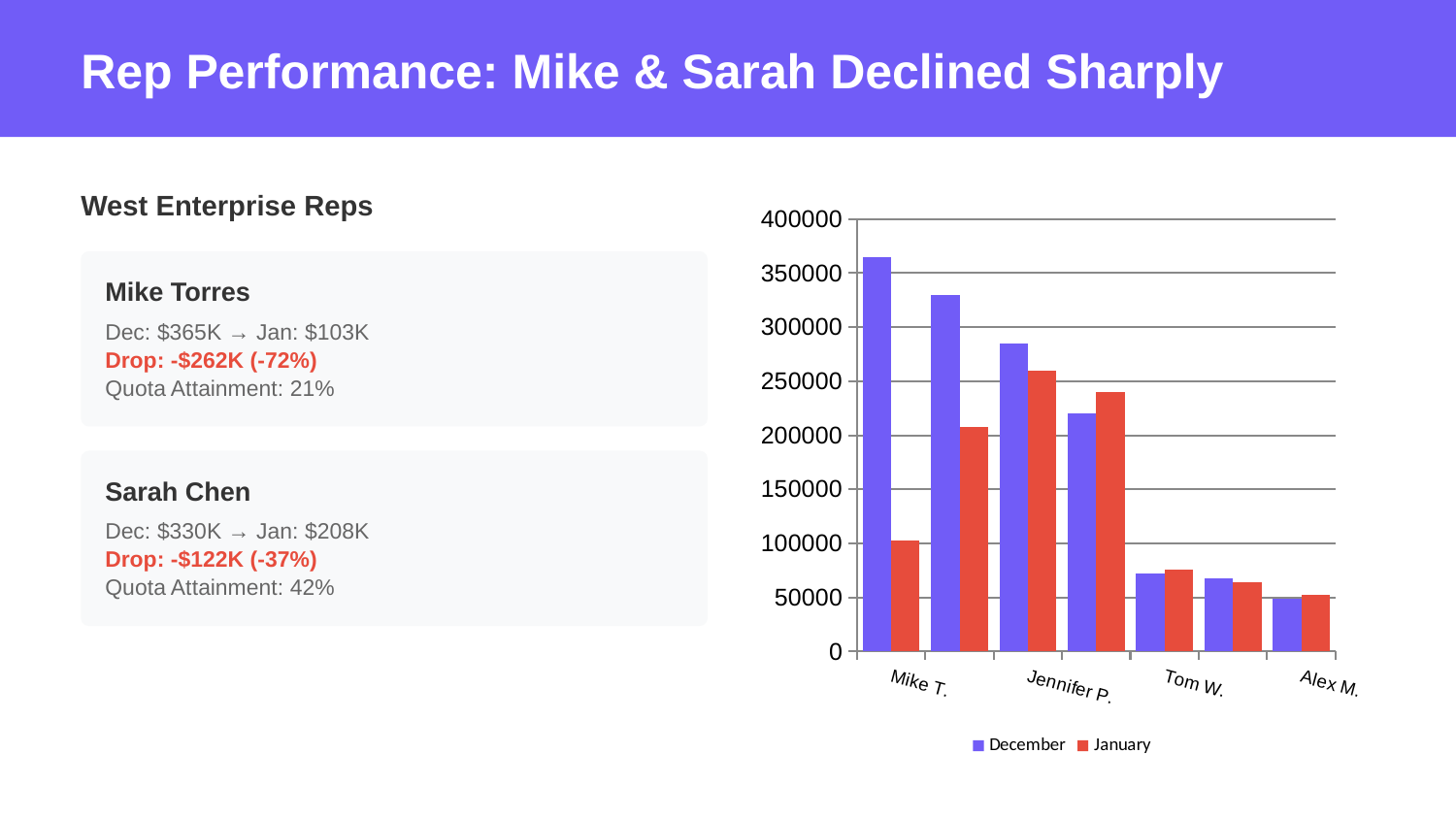
What kind of chart is shown on the slide? bar chart Which labelled rep has the lowest December value? Alex M. Which labelled rep has the highest December value? Mike T. Is the December value for Tom W. greater or less than 100000? less How many groups of bars are plotted in the chart? 7 How many series does the chart legend list? 2 For Mike T., which is larger, the December value or the January value? December Is the January value for Mike T. greater or less than 150000? less Do the December values generally rise or fall from left to right across the chart? fall Is the December value for Mike T. greater or less than 350000? greater Which series is shown in red in the chart? January